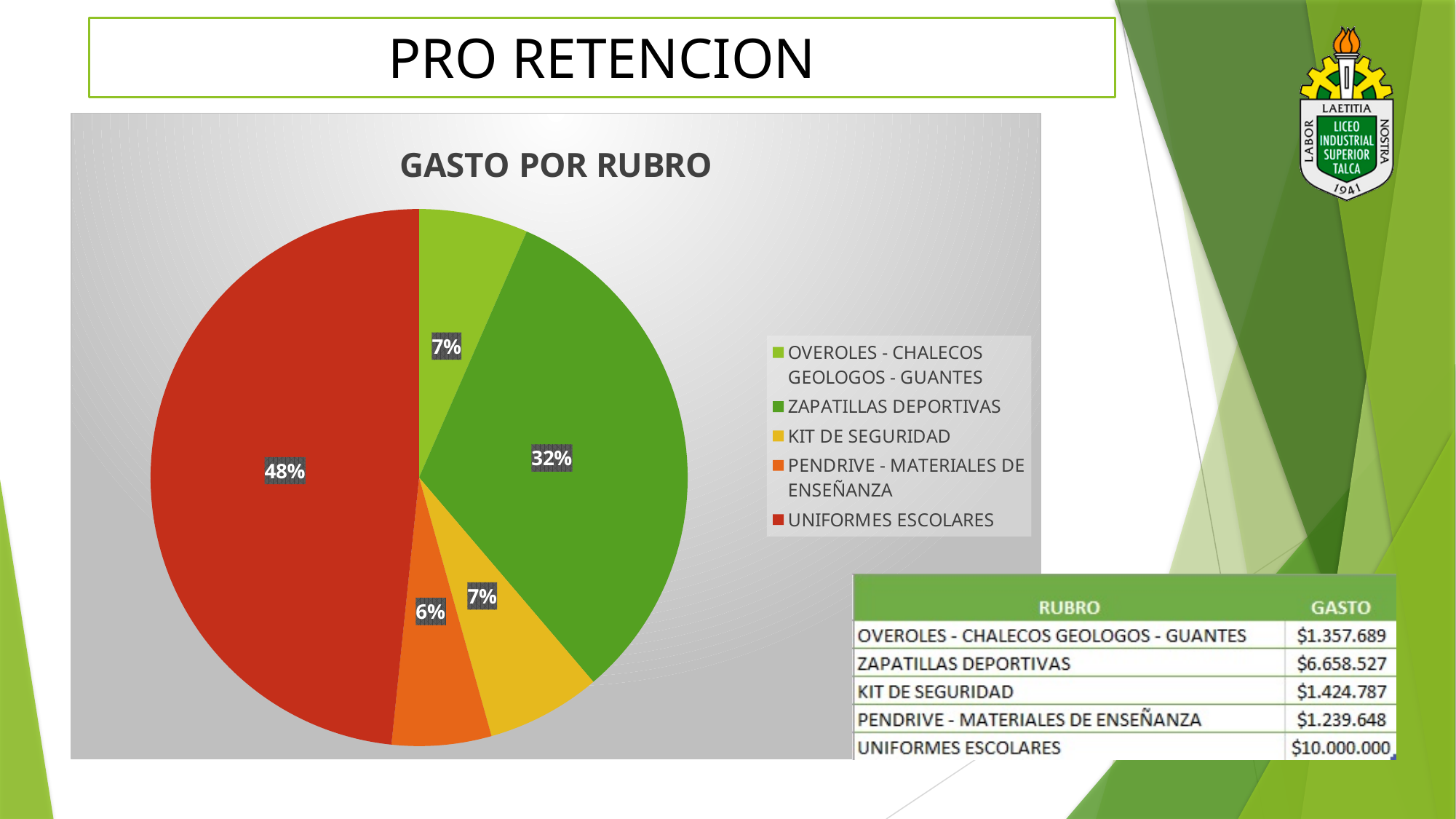
What share of the pie does PENDRIVE - MATERIALES DE ENSEÑANZA represent? 6% What is the title of the chart? GASTO POR RUBRO What type of chart is shown under the title GASTO POR RUBRO? Pie chart Which slice is larger, ZAPATILLAS DEPORTIVAS or KIT DE SEGURIDAD? ZAPATILLAS DEPORTIVAS What share of the pie does KIT DE SEGURIDAD represent? 7% How many slices does the pie chart have? 5 What colour is the UNIFORMES ESCOLARES slice in the pie chart? Red Which category has the largest slice of the pie? UNIFORMES ESCOLARES What is the difference in percentage points between the UNIFORMES ESCOLARES slice and the ZAPATILLAS DEPORTIVAS slice? 16% Which category has the smallest slice of the pie? PENDRIVE - MATERIALES DE ENSEÑANZA What share of the pie does UNIFORMES ESCOLARES represent? 48%